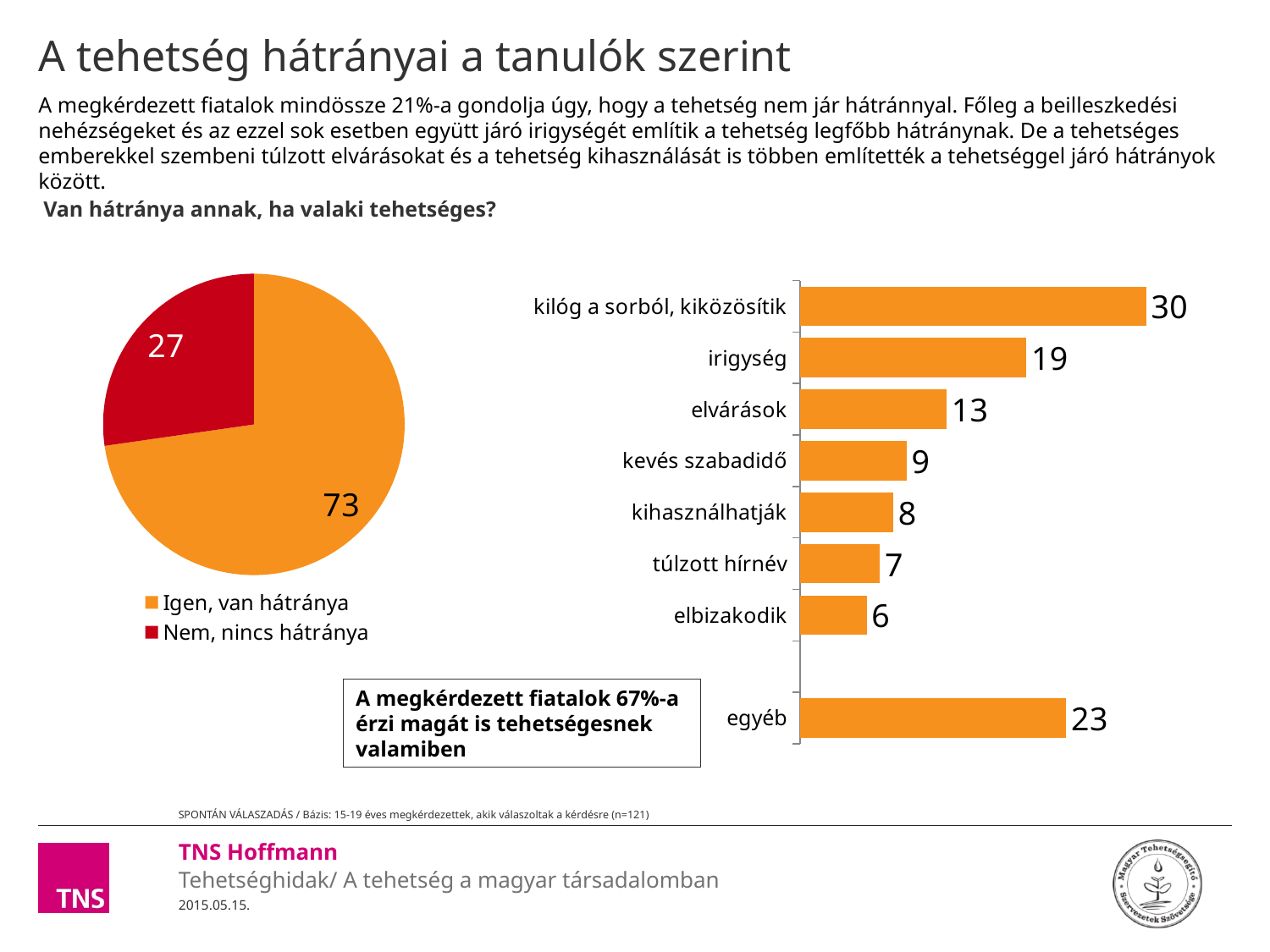
In the bar chart on the right, which category has the highest value? kilóg a sorból, kiközösítik In the bar chart on the right, what is the value for "irigység"? 19 What kind of chart is the chart on the right of the slide? bar chart In the bar chart on the right, what is the value for "kevés szabadidő"? 9 How many categories are shown in the bar chart on the right? 8 In the bar chart on the right, what is the difference between the values for "kilóg a sorból, kiközösítik" and "egyéb"? 7 How many entries does the legend of the pie chart on the left list? 2 In the bar chart on the right, which is larger: the value for "elvárások" or the value for "kihasználhatják"? elvárások In the pie chart on the left, what is the value for "Nem, nincs hátránya"? 27 In the pie chart on the left, what is the value for "Igen, van hátránya"? 73 In the pie chart on the left, which slice is larger: "Igen, van hátránya" or "Nem, nincs hátránya"? Igen, van hátránya In the bar chart on the right, which category has the lowest value? elbizakodik